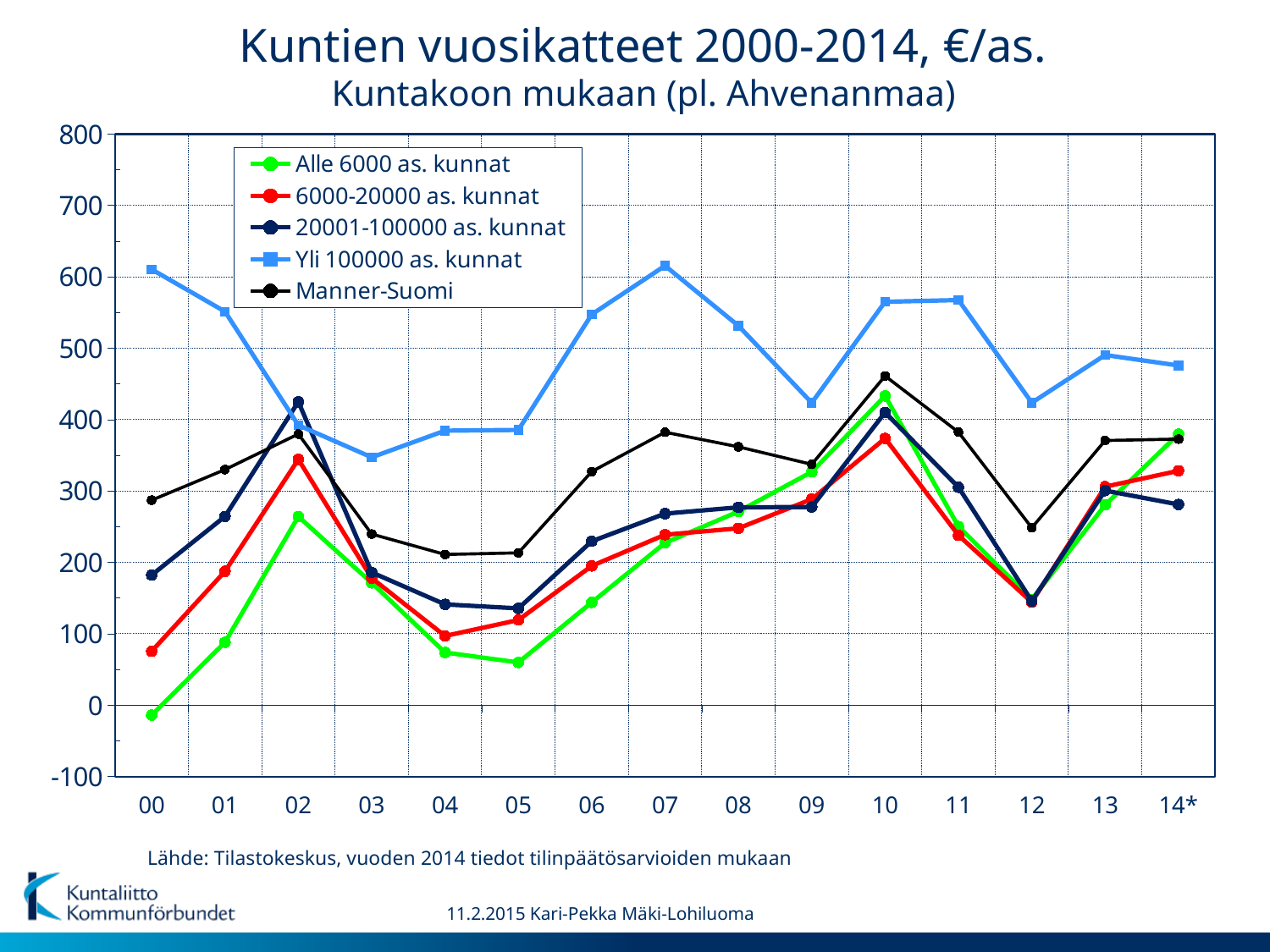
How many series does the legend list? 5 Is the value for Alle 6000 as. kunnat in year 00 greater or less than 0? less In which year is the value for Alle 6000 as. kunnat lowest? 00 Is the value for Yli 100000 as. kunnat in year 03 greater or less than 400? less Does the value for Yli 100000 as. kunnat rise or fall from year 00 to year 03? fall In year 14*, which is larger: Alle 6000 as. kunnat or 20001-100000 as. kunnat? Alle 6000 as. kunnat What kind of chart is shown on the slide? line chart In year 02, which is larger: 20001-100000 as. kunnat or Manner-Suomi? 20001-100000 as. kunnat Which series has the lowest value in year 00? Alle 6000 as. kunnat Which series has the highest value in year 00? Yli 100000 as. kunnat How many years are shown along the x axis? 15 Is the value for Manner-Suomi in year 10 greater or less than 400? greater